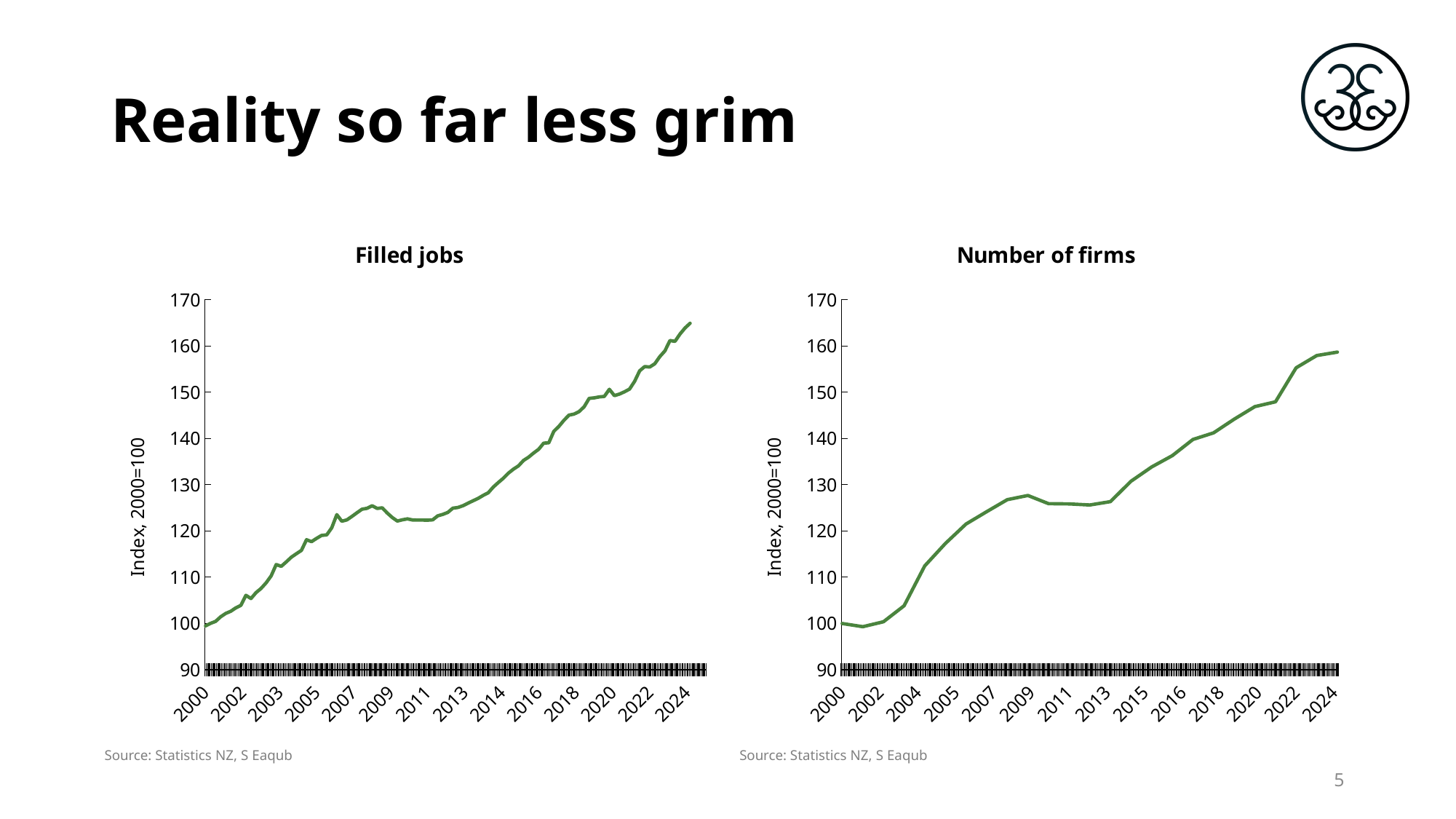
What kind of chart is the 'Number of firms' chart? line chart In the 'Filled jobs' chart, does the index generally rise or fall from 2000 to 2024? rise In the 'Number of firms' chart, is the value at 2016 greater or less than 130? greater In the 'Number of firms' chart, does the index generally rise or fall from 2000 to 2024? rise What is the y-axis label on the 'Filled jobs' chart? Index, 2000=100 In the 'Filled jobs' chart, is the value at 2011 greater or less than 130? less In the 'Number of firms' chart, is the value at 2024 greater or less than 160? less What source is cited below the 'Number of firms' chart? Statistics NZ, S Eaqub What kind of chart is the 'Filled jobs' chart? line chart Which chart ends at a higher index value in 2024, 'Filled jobs' or 'Number of firms'? Filled jobs